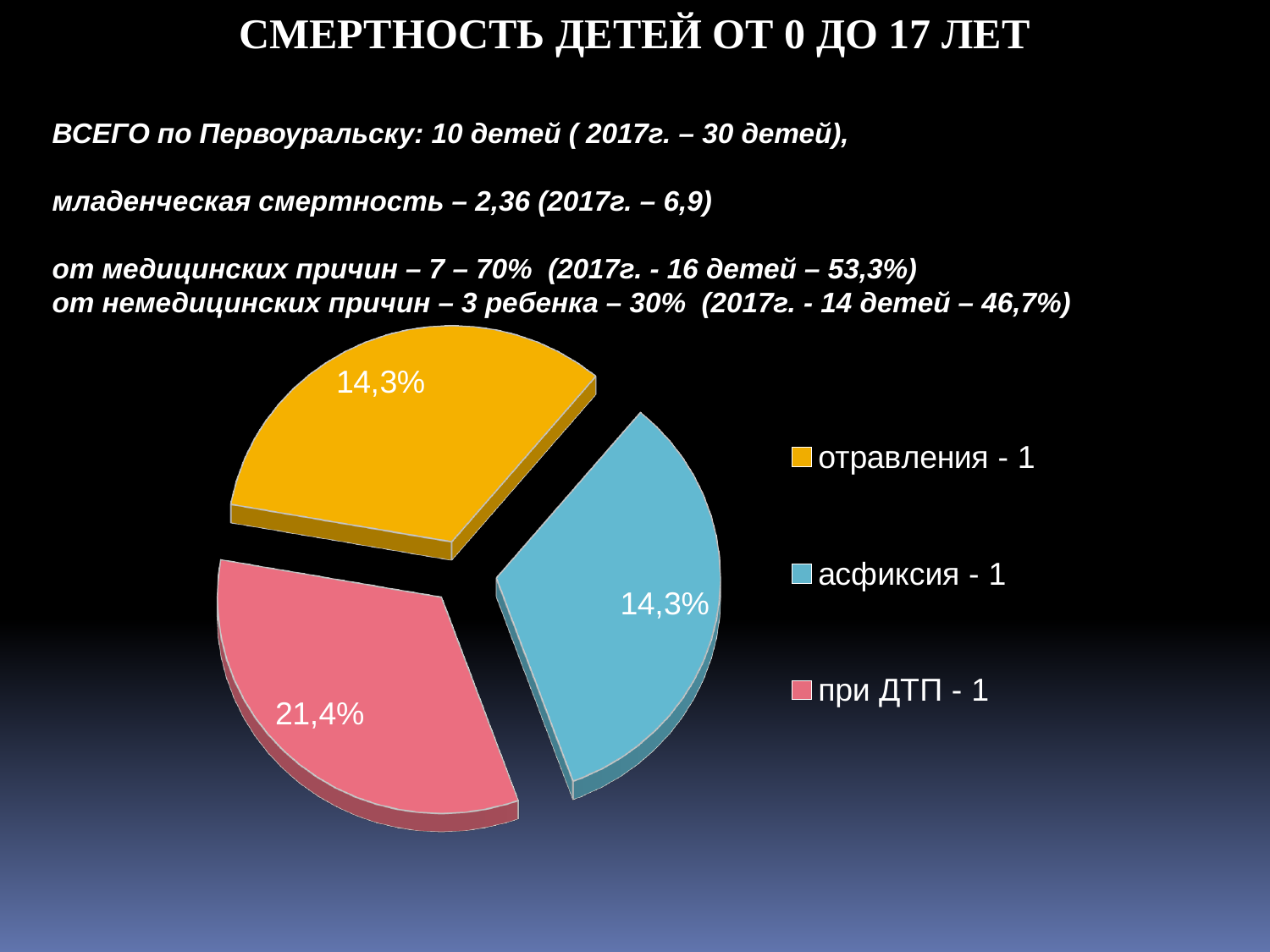
What kind of chart is shown on the slide? pie chart What percentage is shown for the "отравления - 1" slice? 14,3% Which is larger: the "при ДТП - 1" slice or the "отравления - 1" slice? при ДТП - 1 What is the difference in percentage points between the "при ДТП - 1" slice and the "асфиксия - 1" slice? 7,1% Which slice of the pie chart has the largest percentage? при ДТП - 1 How many entries does the legend list? 3 What colour is the "при ДТП - 1" slice? pink What percentage is shown for the "асфиксия - 1" slice? 14,3% What percentage is shown for the "при ДТП - 1" slice? 21,4% What colour is the "асфиксия - 1" slice? blue How many slices does the pie chart have? 3